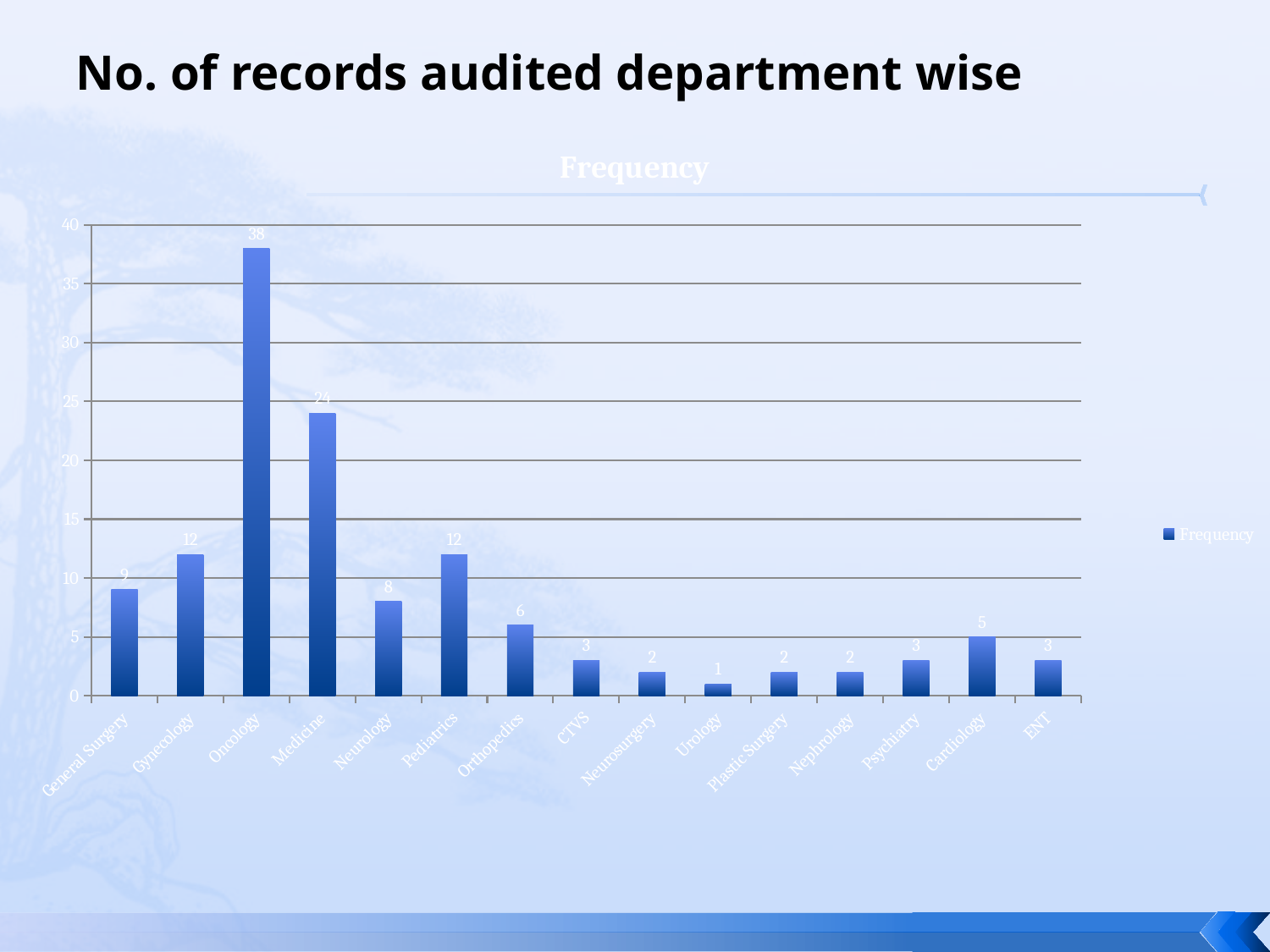
What is the frequency for Medicine? 24 How many series does the legend list? 1 Which department has the lowest frequency? Urology How many departments are shown on the x axis? 15 What kind of chart is shown on the slide? Bar chart Is the value for Oncology greater or less than 35? greater Which has a higher frequency, Gynecology or Orthopedics? Gynecology Which department has the highest frequency? Oncology What is the frequency for Oncology? 38 What is the title of the chart? Frequency What is the difference between the frequency for Oncology and the frequency for Medicine? 14 What is the frequency for Neurology? 8